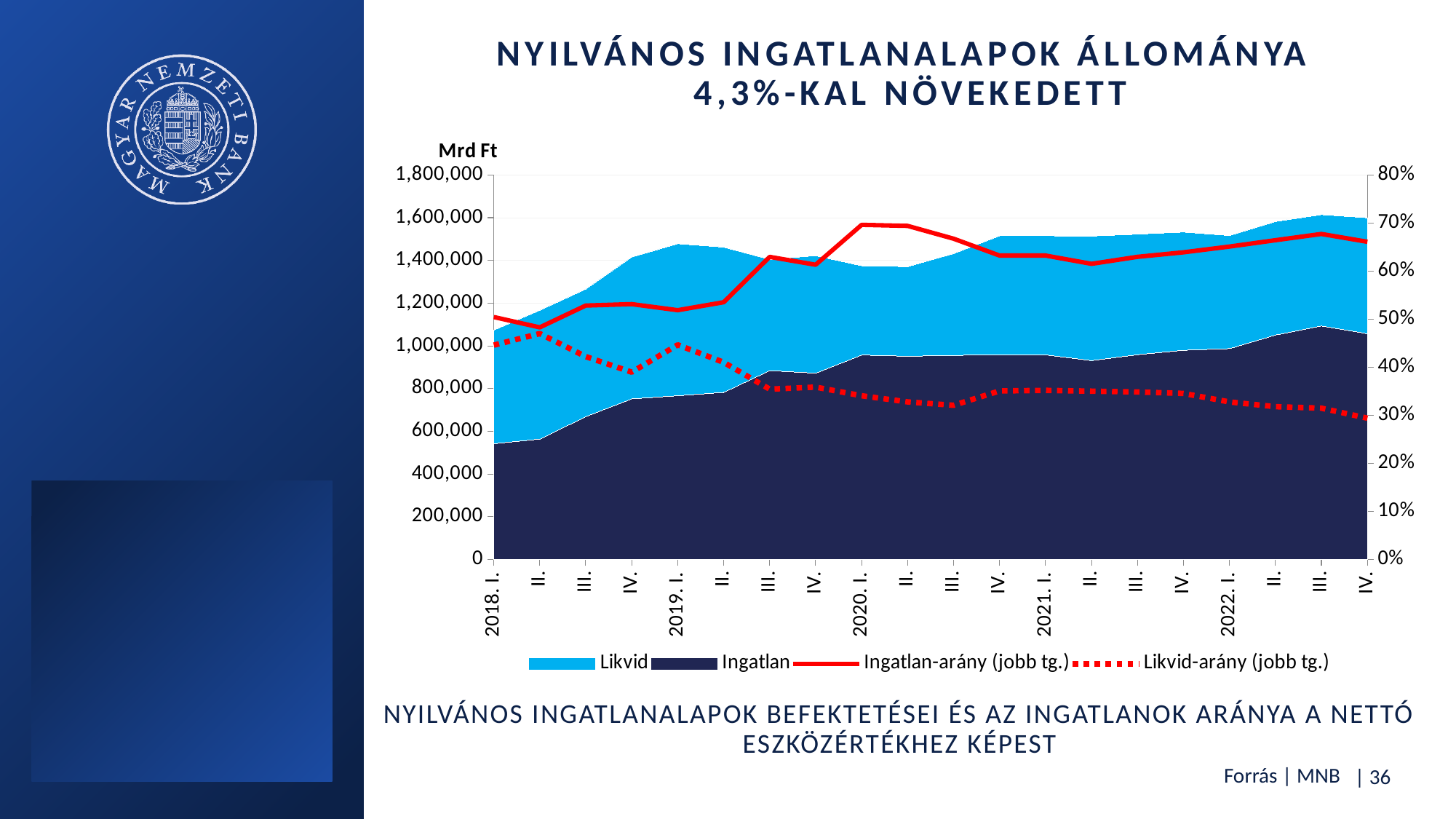
What unit is shown for the left-hand axis? Mrd Ft Is the Ingatlan value at 2018. I. greater or less than 600,000? less At 2022. IV., which is larger: Ingatlan-arány (jobb tg.) or Likvid-arány (jobb tg.)? Ingatlan-arány (jobb tg.) Is the value of Likvid-arány (jobb tg.) at 2019. I. greater or less than 40%? greater How many quarterly points are shown along the x axis? 20 What kind of chart is shown on the slide? Stacked area chart with two line series Which series are plotted on the right-hand axis according to the legend? Ingatlan-arány and Likvid-arány Is the value of Ingatlan-arány (jobb tg.) at 2020. I. greater or less than 60%? greater Does the Ingatlan series generally rise or fall from 2018. I. to 2022. IV.? rise How many series does the legend list? 4